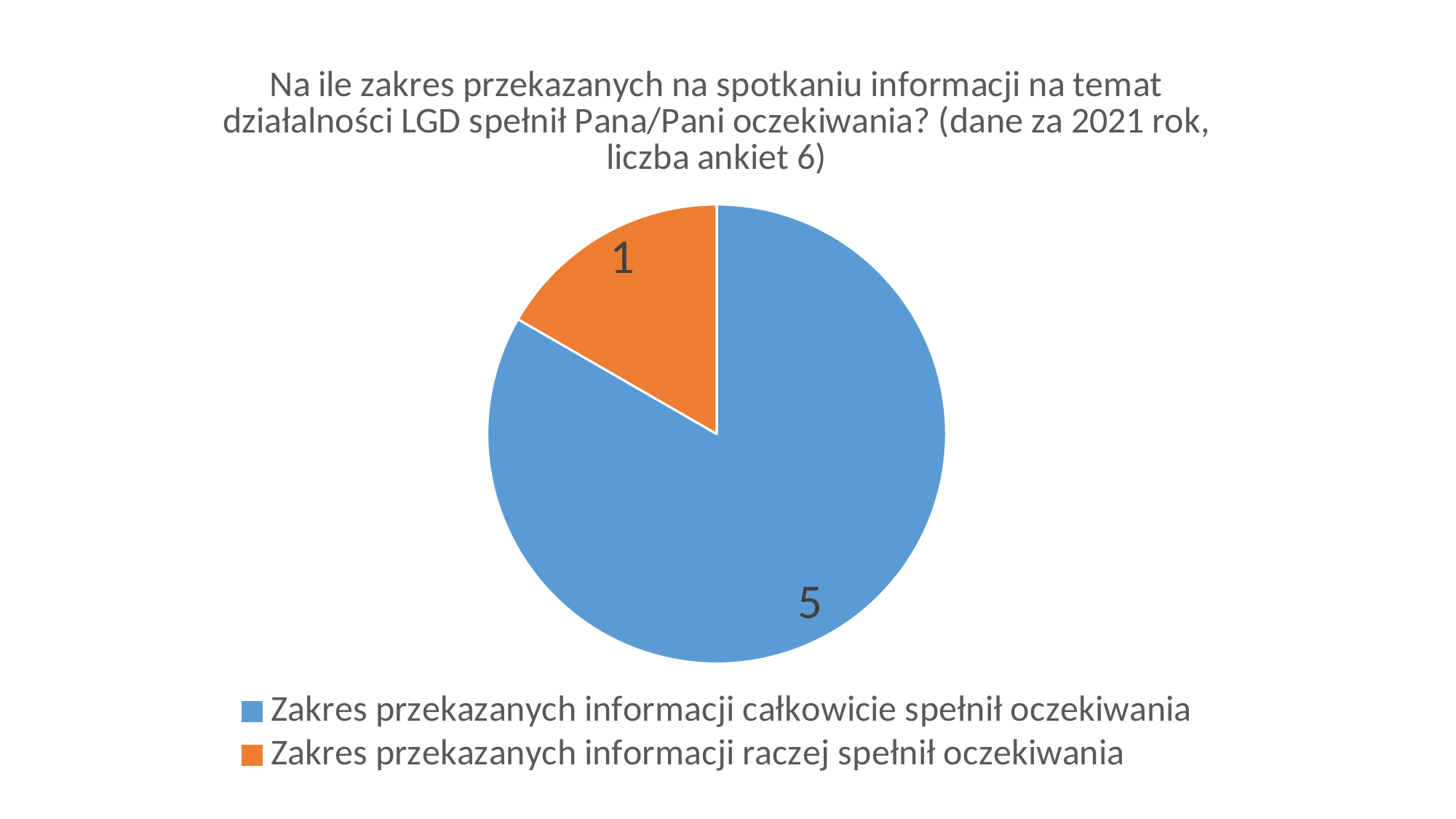
Which category has the smallest slice of the pie? Zakres przekazanych informacji raczej spełnił oczekiwania What is the value for "Zakres przekazanych informacji całkowicie spełnił oczekiwania"? 5 Which is larger: the value for "całkowicie spełnił oczekiwania" or the value for "raczej spełnił oczekiwania"? całkowicie spełnił oczekiwania Which category has the largest slice of the pie? Zakres przekazanych informacji całkowicie spełnił oczekiwania How many slices does the pie chart have? 2 What share of the pie does "Zakres przekazanych informacji raczej spełnił oczekiwania" represent, as a fraction? 1/6 What is the value for "Zakres przekazanych informacji raczej spełnił oczekiwania"? 1 How many entries does the legend list? 2 What colour is the slice for "Zakres przekazanych informacji raczej spełnił oczekiwania"? orange What is the total of all slices in the pie chart? 6 What kind of chart is shown on the slide? pie chart What is the difference between the value for "całkowicie spełnił oczekiwania" and the value for "raczej spełnił oczekiwania"? 4